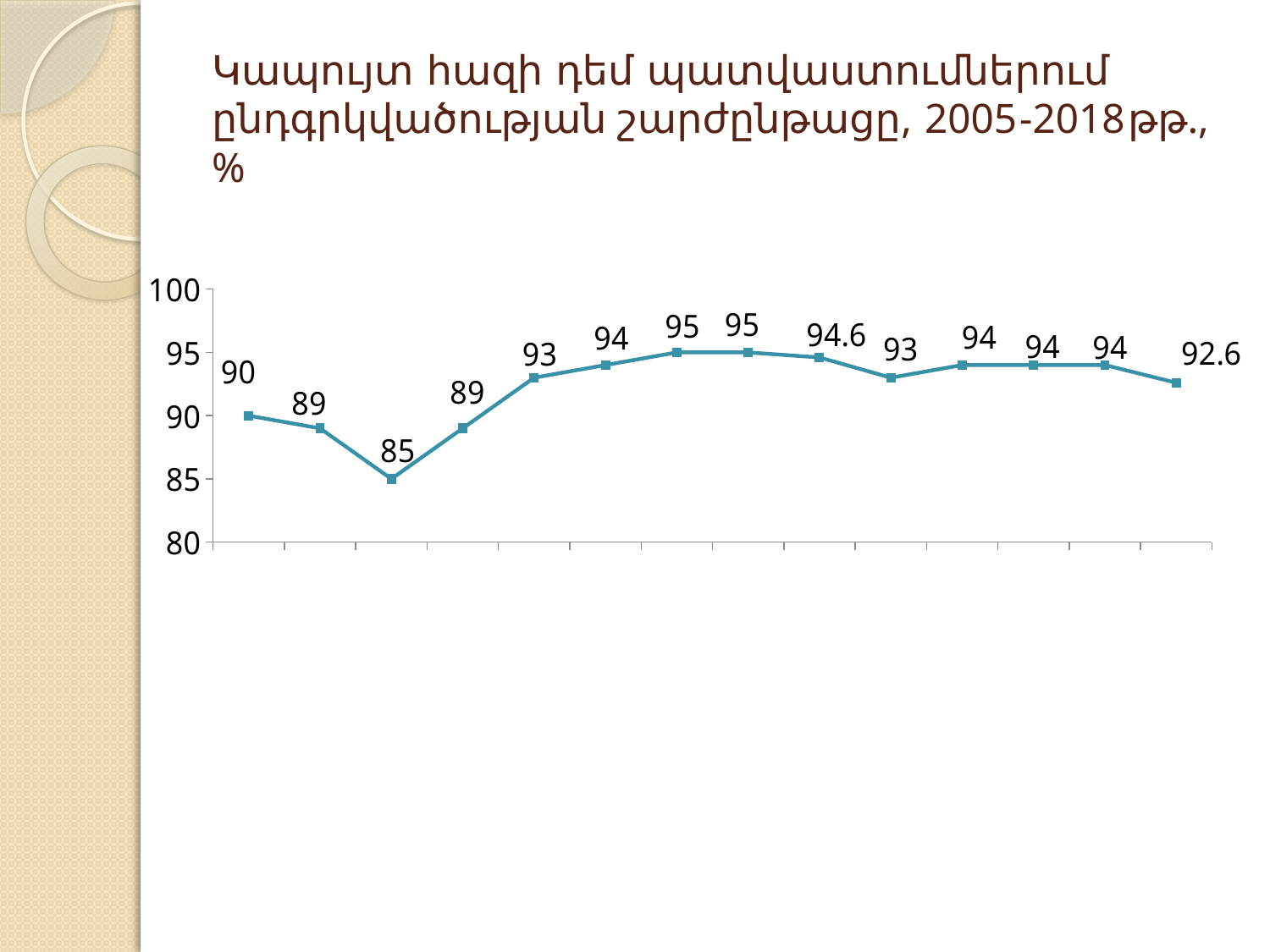
What type of chart is shown on the slide? line chart What is the value of the ninth data point on the line? 94.6 What is the lowest value shown on the line? 85 Which is larger, the third data point or the fourth data point? the fourth data point What is the value of the last data point on the line? 92.6 Is the value of the third data point greater or less than 90? less What is the difference between the highest value (95) and the lowest value (85) on the line? 10 What is the highest value shown on the line? 95 What is the difference between the last data point (92.6) and the first data point (90)? 2.6 What is the value of the first data point on the line? 90 Do the values rise or fall from the third data point to the seventh data point? rise How many data points are plotted on the line? 14